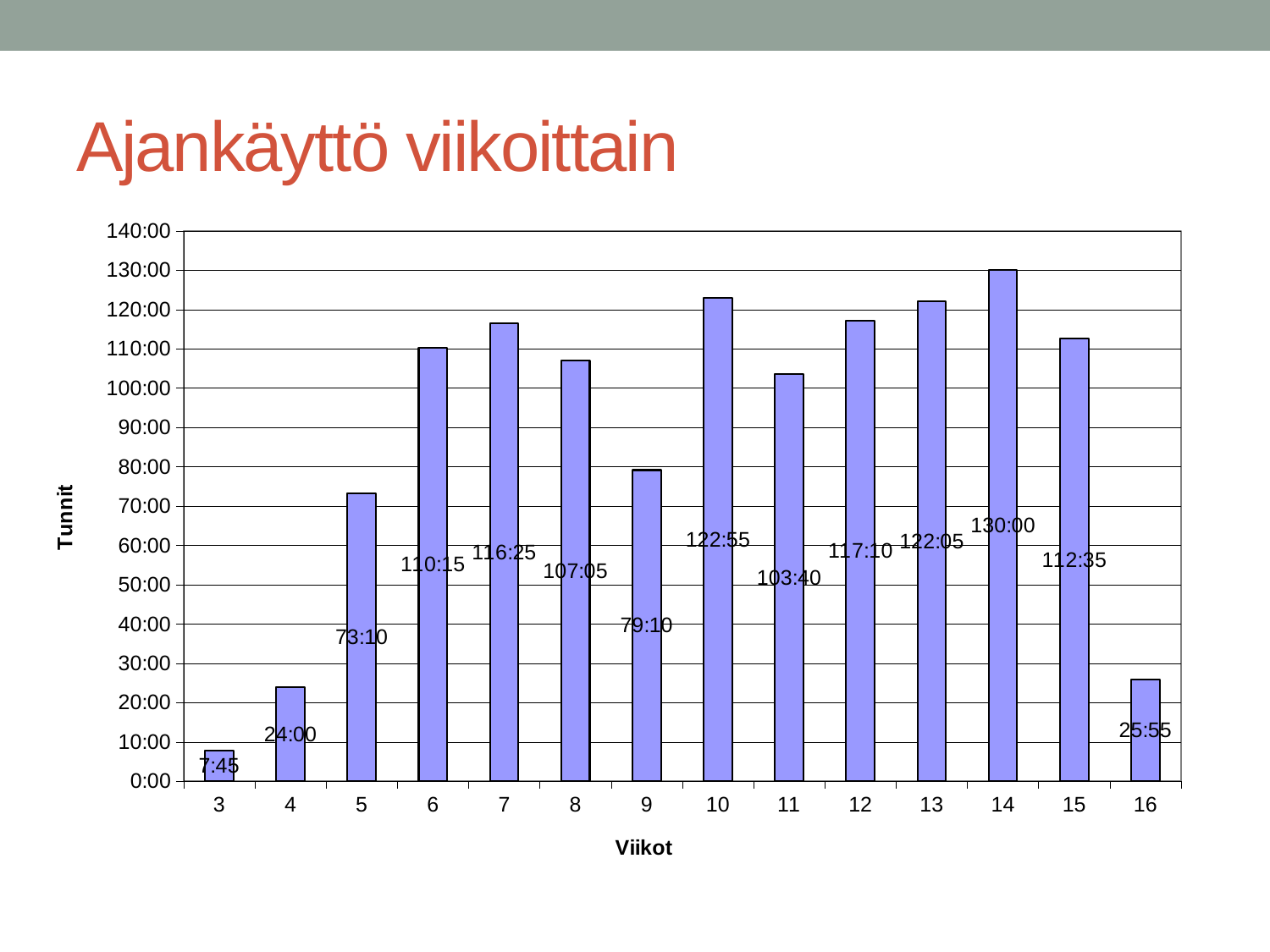
Which week has the lowest value? 3 Is the value for week 5 greater or less than 80:00? less How many weeks are shown on the x axis? 14 What is the value for week 9? 79:10 Which is larger, the value for week 7 or the value for week 8? week 7 What is the difference between the values for week 10 and week 9? 43:45 What is the value for week 14? 130:00 What is the difference between the values for week 14 and week 3? 122:15 What is the value for week 3? 7:45 Which week has the highest value? 14 What is the label of the y axis? Tunnit What kind of chart is shown on the slide? bar chart